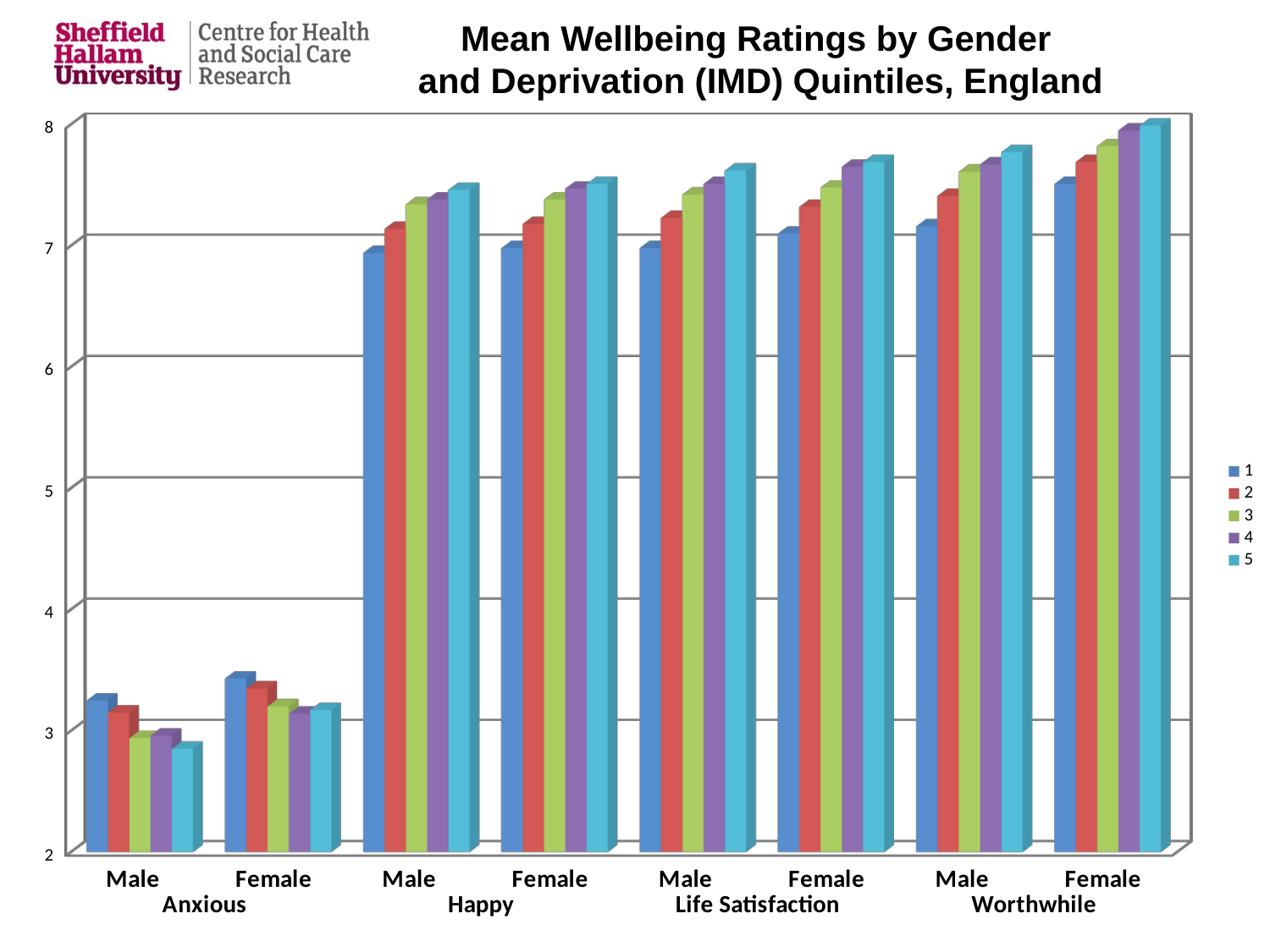
Is the value for series 1 in the Anxious Male group greater or less than 3? greater Is the value for series 1 in the Worthwhile Male group greater or less than 7? greater How many series does the legend list? 5 Is the value for series 5 in the Anxious Male group greater or less than 3? less How many Male/Female category groups are shown along the x axis? 8 What is the title of the chart? Mean Wellbeing Ratings by Gender and Deprivation (IMD) Quintiles, England Within the Happy Male group, which series has the lowest value? 1 What kind of chart is shown on the slide? bar chart Which is larger for series 1: the Anxious Male value or the Anxious Female value? Anxious Female Which is larger for series 1: the Happy Female value or the Worthwhile Female value? Worthwhile Female Within the Happy Male group, do the values rise or fall from series 1 to series 5? rise